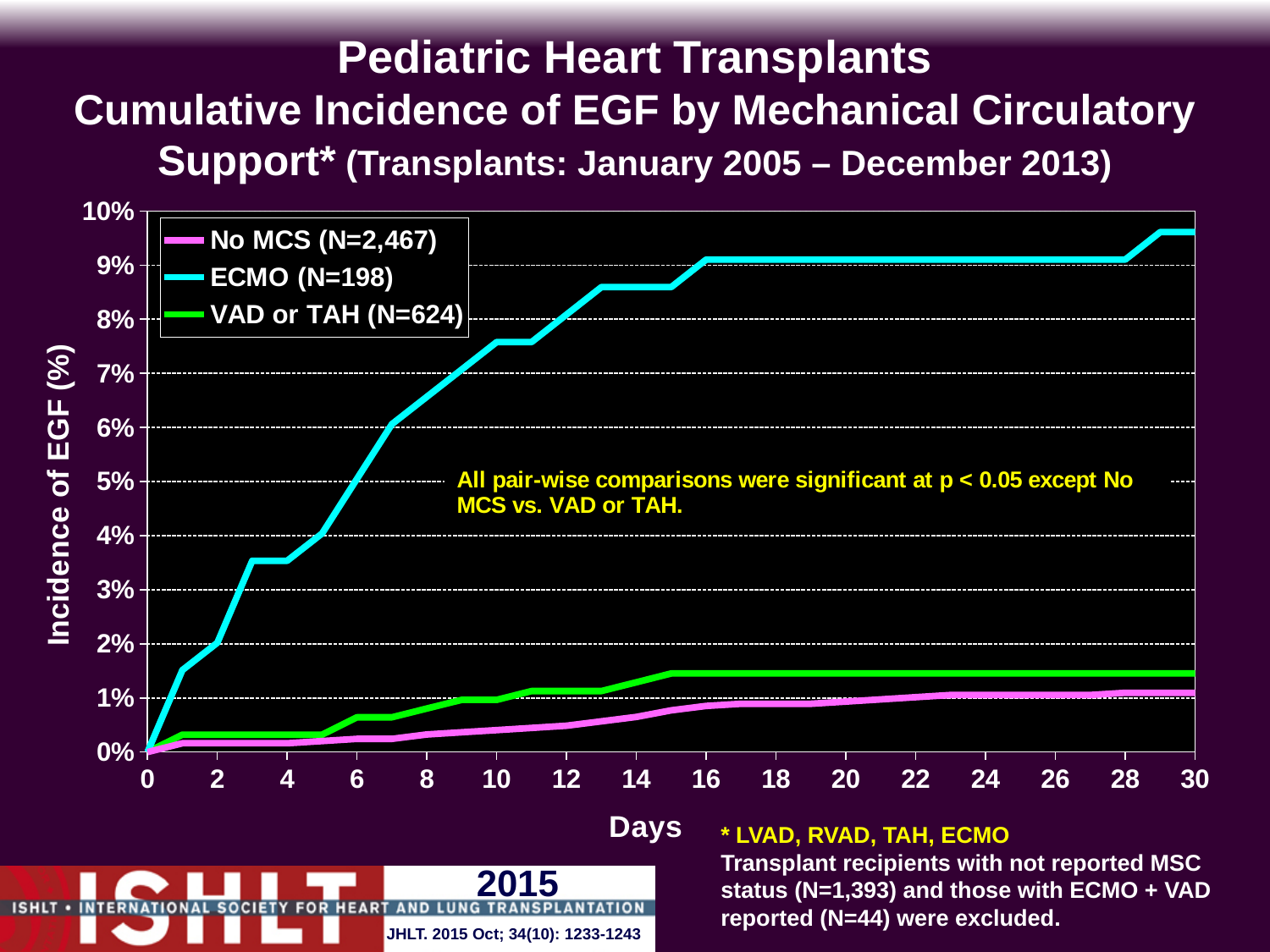
Which series has the lowest incidence of EGF at day 30? No MCS (N=2,467) Is the incidence of EGF for ECMO at day 8 greater or less than 6%? greater At day 20, which series has the larger incidence of EGF, ECMO or VAD or TAH? ECMO What is the label of the x axis? Days What kind of chart is shown on the slide? line chart Is the incidence of EGF for No MCS at day 30 greater or less than 2%? less Is the incidence of EGF for ECMO at day 30 greater or less than 9%? greater Does the incidence of EGF for ECMO rise or fall as days increase? rise Which series has the highest incidence of EGF at day 30? ECMO (N=198) How many series does the legend list? 3